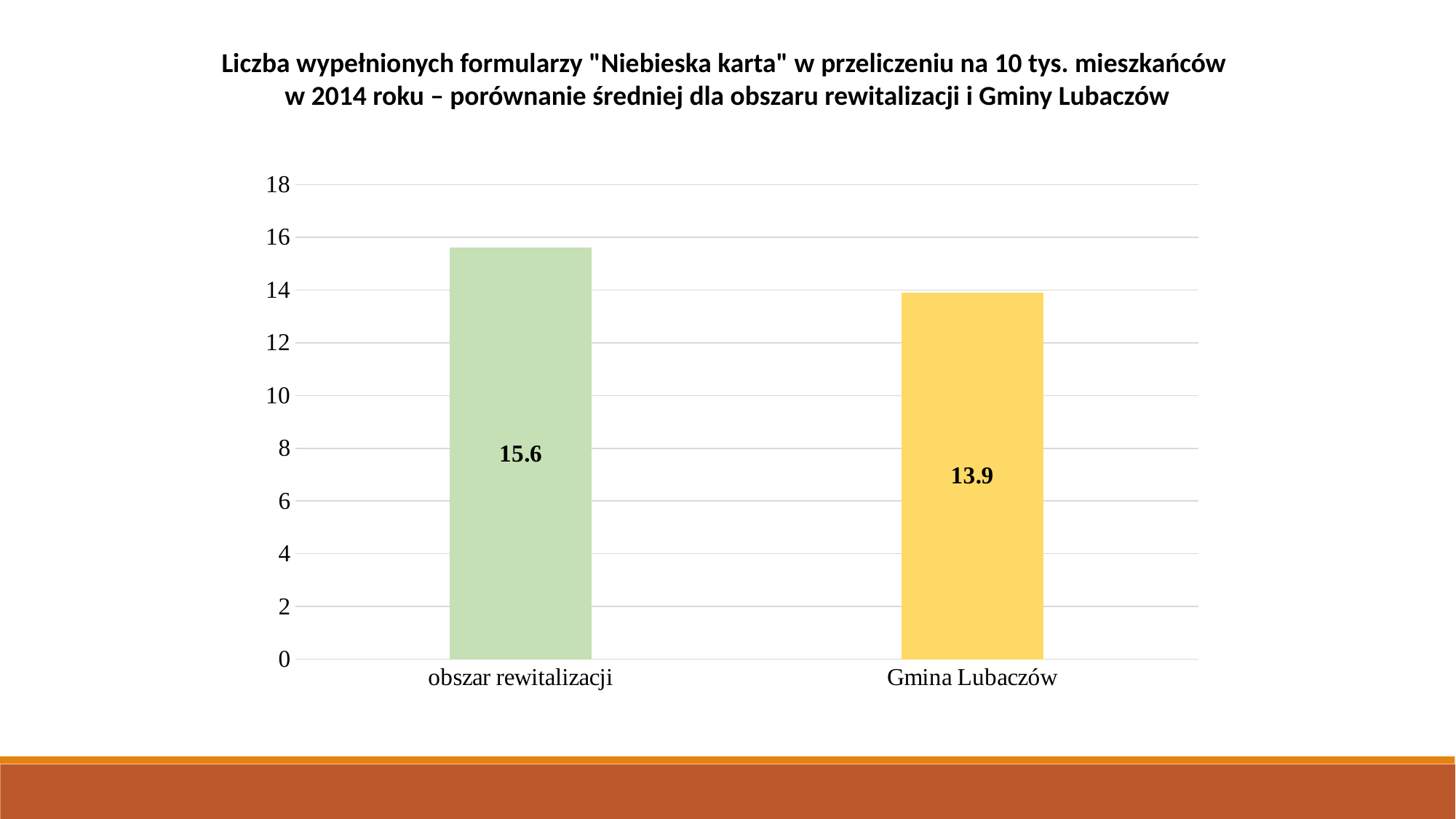
Which category has the highest value? obszar rewitalizacji What is the value for obszar rewitalizacji? 15.6 Which is larger, the value for obszar rewitalizacji or the value for Gmina Lubaczów? obszar rewitalizacji How many categories are shown on the chart? 2 What is the value for Gmina Lubaczów? 13.9 What kind of chart is shown on the slide? bar chart What is the difference between the values for obszar rewitalizacji and Gmina Lubaczów? 1.7 What is the maximum value shown on the vertical axis? 18 What colour is the bar for Gmina Lubaczów? yellow Which category has the lowest value? Gmina Lubaczów Is the value for obszar rewitalizacji greater or less than 14? greater Is the value for Gmina Lubaczów greater or less than 14? less